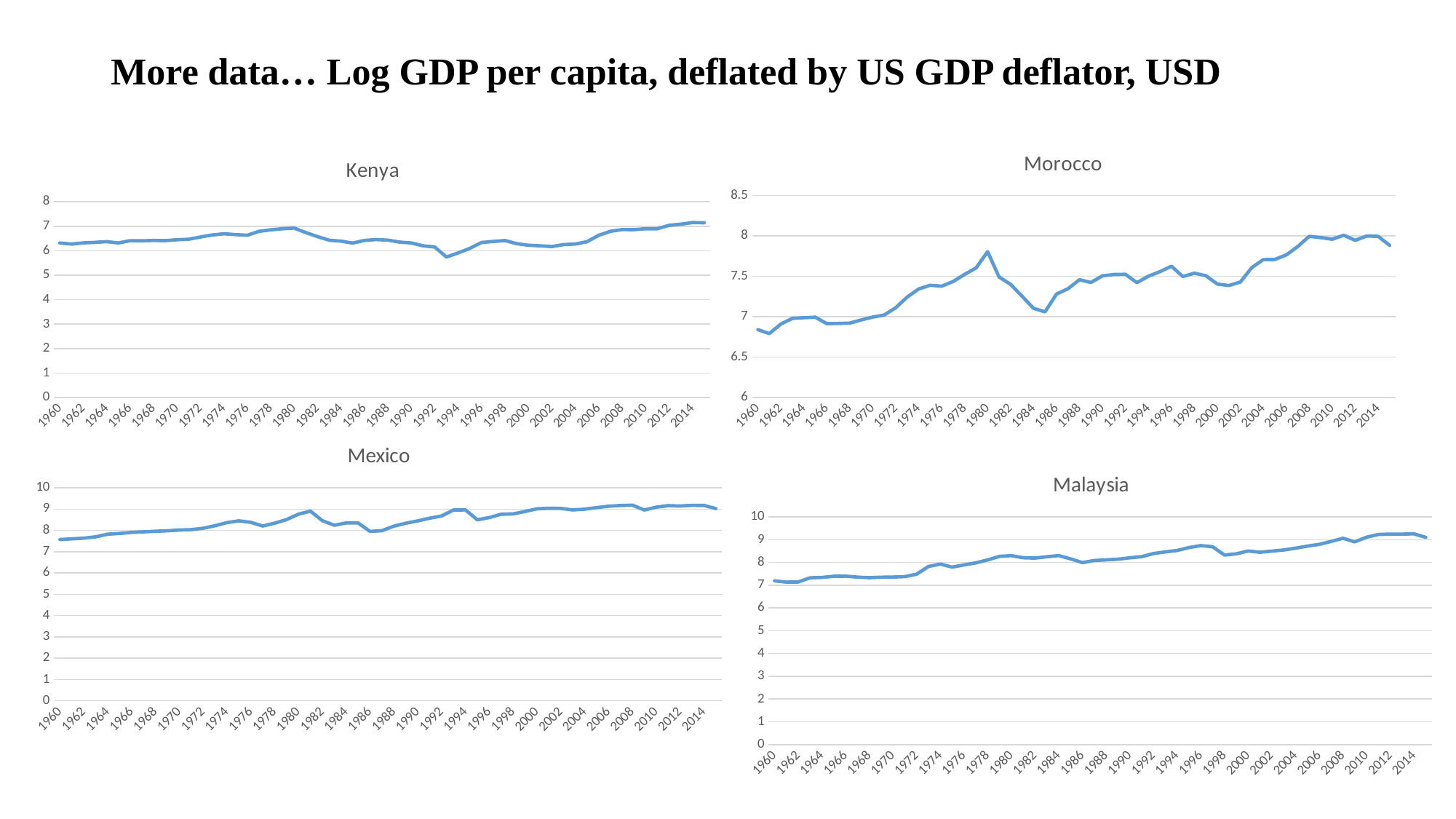
In the Malaysia chart, do the values generally rise or fall from 1960 to 2014? rise In the Mexico chart, is the value for 2014 greater or less than 9? greater In the Mexico chart, which year has the lowest value? 1960 In the Morocco chart, is the value for 1960 greater or less than 7? less What kind of chart is the Kenya chart? line chart In the Kenya chart, is the value for 1993 greater or less than 6? less How many charts are shown on the slide? 4 In the Kenya chart, which year has the lowest value? 1993 Which four countries are the charts on the slide titled after? Kenya, Morocco, Mexico, Malaysia